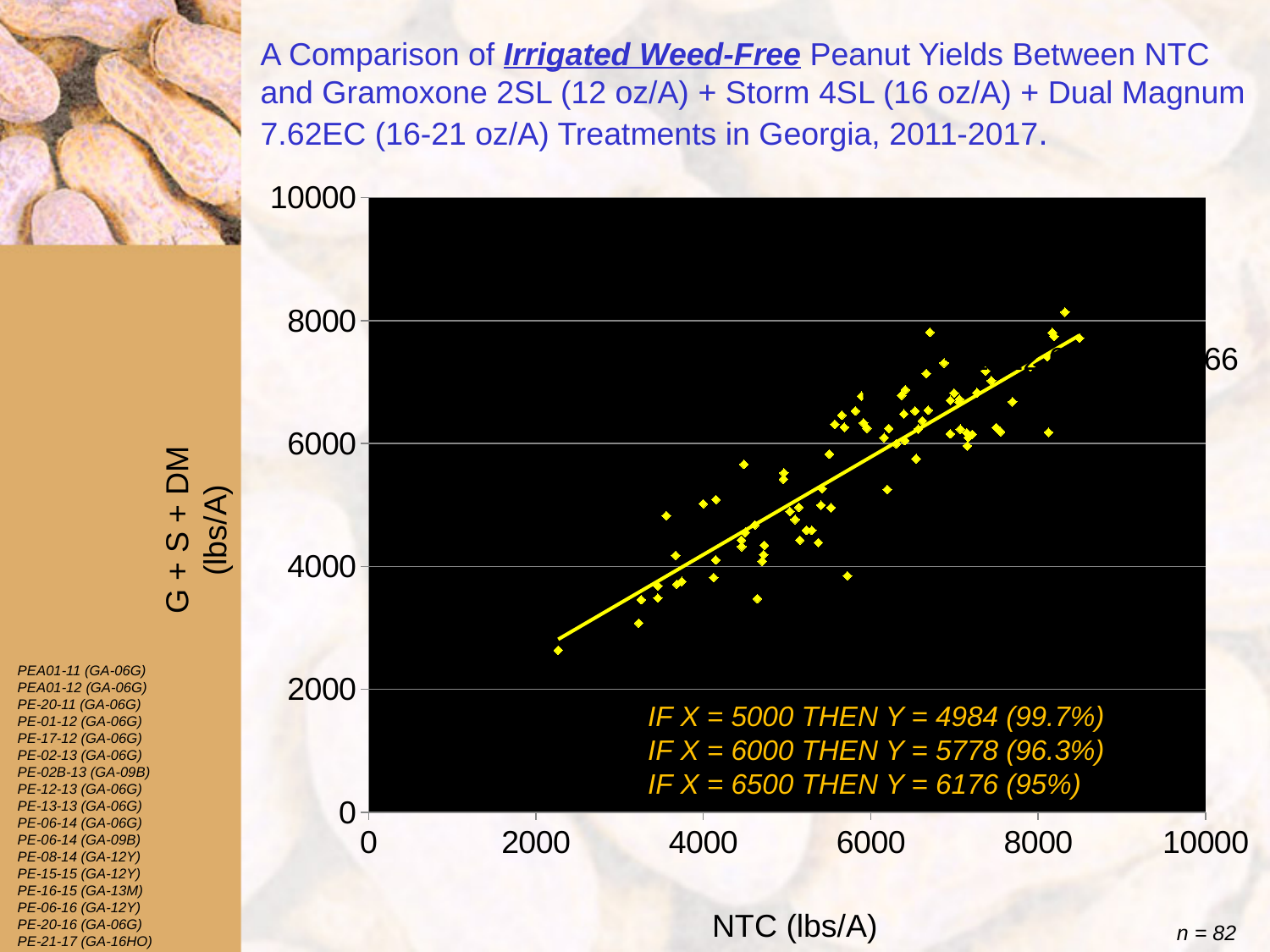
Do the G + S + DM yields generally rise or fall as NTC yield increases along the x axis? rise Is the trend line's G + S + DM value at NTC = 8000 greater or less than 6000? greater What is the difference between the annotated Y value at X = 6000 and the annotated Y value at X = 5000? 794 According to the annotation on the chart, what is Y when X = 6500? 6176 What is the label of the x axis? NTC (lbs/A) Which annotated Y value is larger: the one for X = 6500 or the one for X = 5000? X = 6500 Is the G + S + DM value of the lowest plotted point greater or less than 4000? less How many data points (n) does the chart report? 82 What kind of chart is shown on the slide? scatter chart According to the annotation on the chart, what is Y when X = 5000? 4984 What is the label of the y axis? G + S + DM (lbs/A) According to the annotation on the chart, what percentage is given for X = 6000? 96.3%